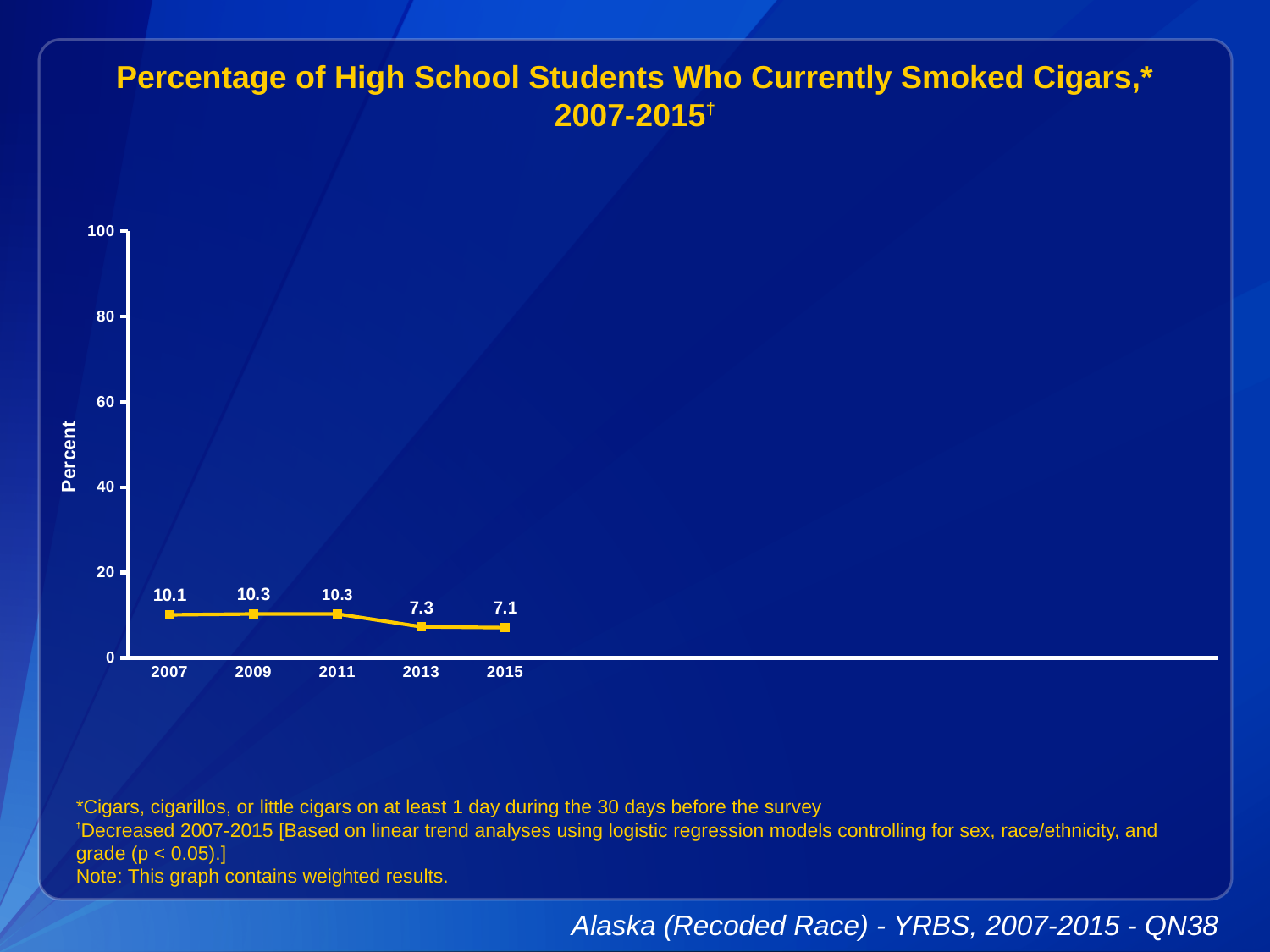
What percentage of high school students currently smoked cigars in 2007? 10.1 What is the value plotted for 2015? 7.1 What is the value plotted for 2013? 7.3 Do the values generally rise or fall from 2007 to 2015? fall Which is larger, the value for 2009 or the value for 2013? 2009 What kind of chart is shown on the slide? line chart What is the label on the vertical axis of the chart? Percent What is the difference between the 2011 value and the 2013 value? 3.0 Is the value for 2011 greater or less than 20? less Which year has the lowest percentage of students who currently smoked cigars? 2015 What is the difference between the 2007 value and the 2015 value? 3.0 How many years are plotted on the chart? 5